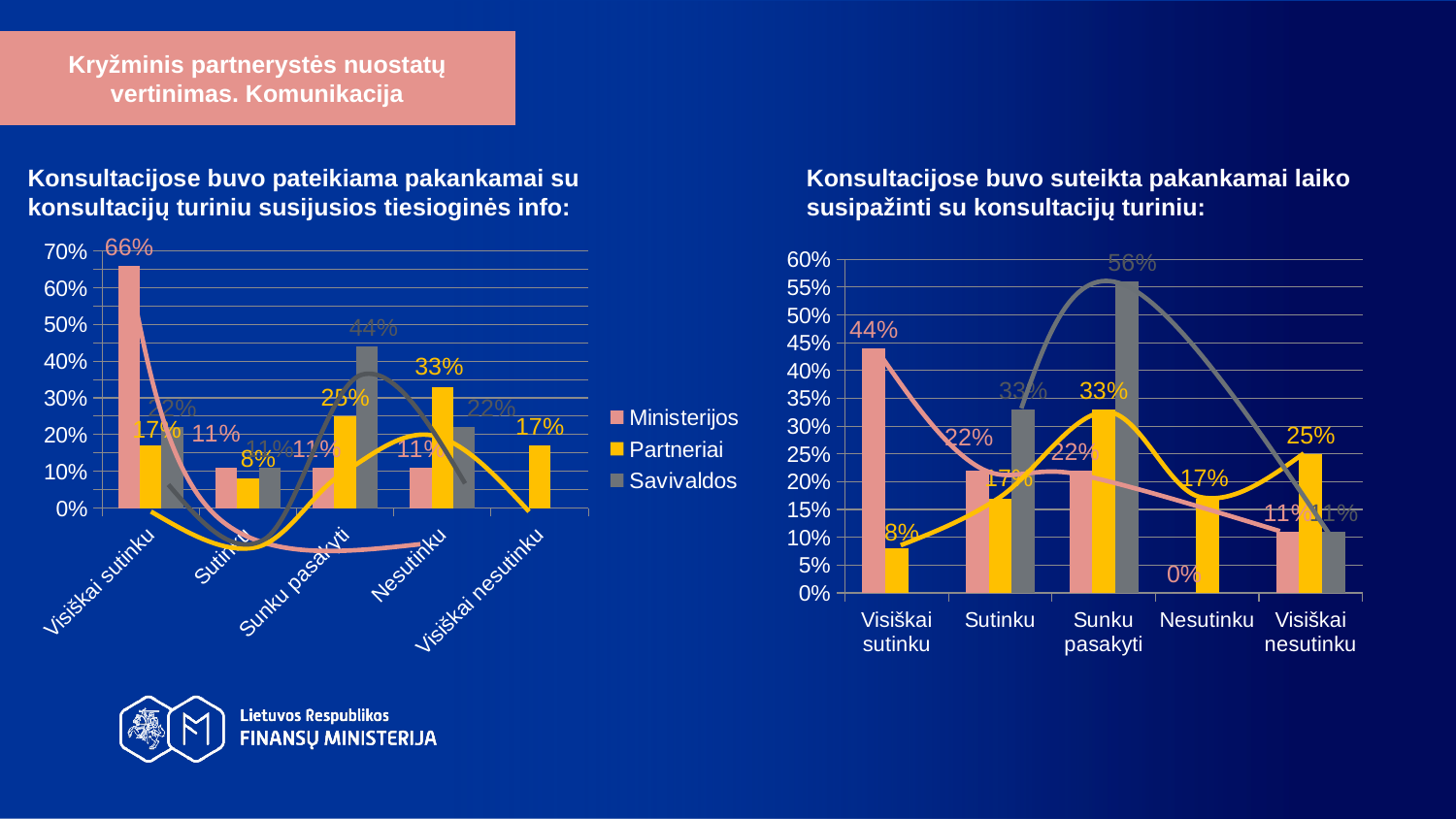
On the right chart, what is the value for Partneriai at Visiškai nesutinku? 25% On the right chart, what is the value for Ministerijos at Visiškai sutinku? 44% On the left chart, what is the value for Savivaldos at Sunku pasakyti? 44% On the left chart ("Konsultacijose buvo pateikiama pakankamai su konsultacijų turiniu susijusios tiesioginės info"), what is the value for Ministerijos at Visiškai sutinku? 66% What kind of chart is the right chart? Bar chart On the left chart, which series has the highest value at Visiškai sutinku? Ministerijos On the right chart, which is larger at Visiškai nesutinku: the Partneriai value or the Ministerijos value? Partneriai On the right chart, how many categories are shown on the x axis? 5 On the left chart, what is the value for Partneriai at Nesutinku? 33% How many series does the legend list? 3 On the right chart ("Konsultacijose buvo suteikta pakankamai laiko susipažinti su konsultacijų turiniu"), what is the value for Savivaldos at Sunku pasakyti? 56% On the left chart, what is the difference between the Ministerijos value at Visiškai sutinku (66%) and the Savivaldos value at Sunku pasakyti (44%)? 22 percentage points